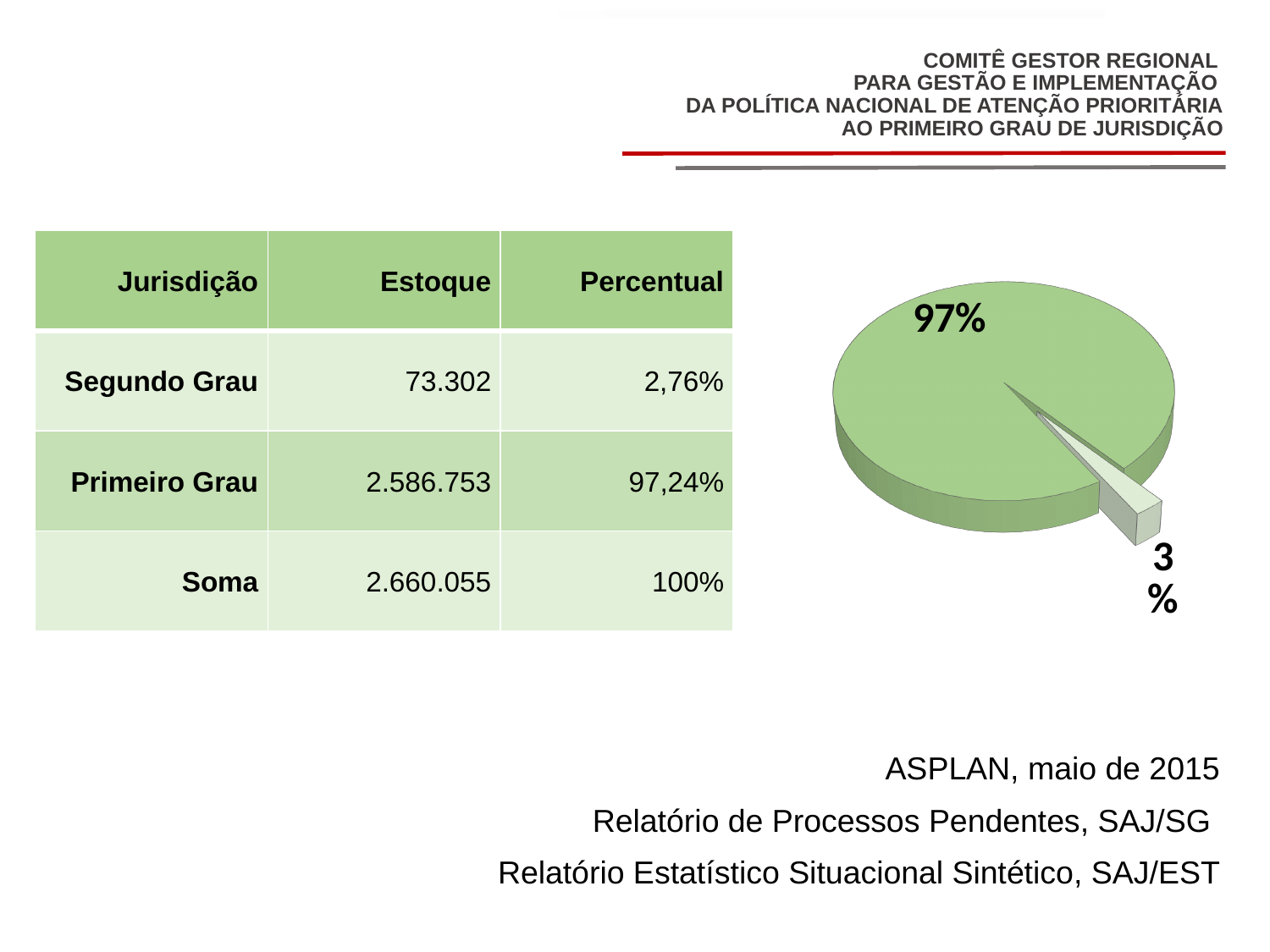
What share of the pie does the small pulled-out slice represent? 3% Which slice of the pie chart is larger, the one labelled 97% or the one labelled 3%? the one labelled 97% What percentage is shown on the smallest slice of the pie chart? 3% By how many percentage points does the larger slice of the pie chart exceed the smaller slice? 94 percentage points Is the share of the smaller slice of the pie chart greater or less than 10%? less Does the pie chart display a legend? No What kind of chart is shown on the right of the slide? pie chart What share of the pie does the large green slice represent? 97% What percentage is shown on the largest slice of the pie chart? 97% How many slices does the pie chart have? 2 Is the share of the larger slice of the pie chart greater or less than 90%? greater According to the table beside the pie chart, which jurisdiction does the 97% slice correspond to? Primeiro Grau